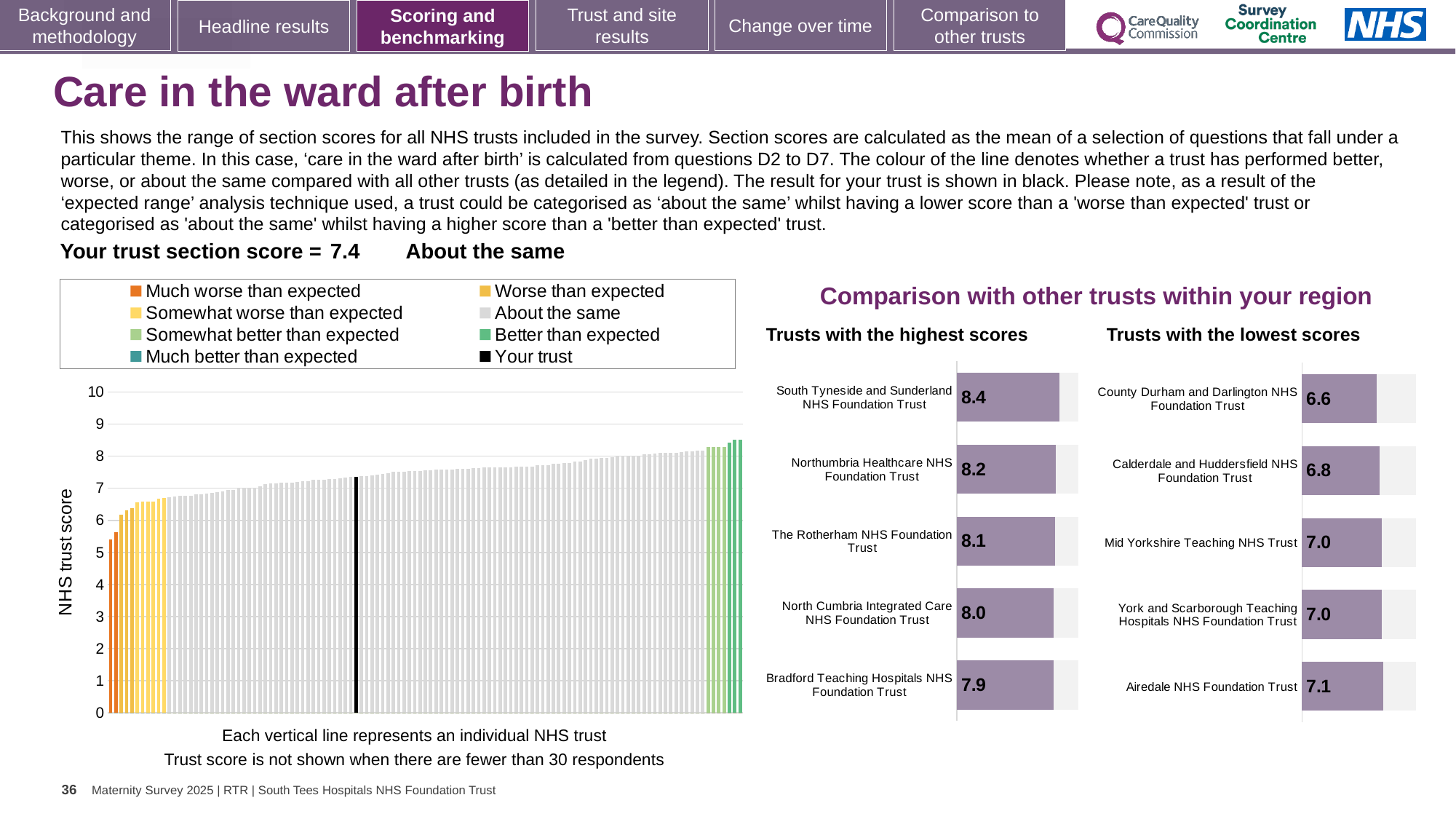
In the 'Trusts with the highest scores' chart, what is the score for South Tyneside and Sunderland NHS Foundation Trust? 8.4 In the main 'NHS trust score' chart, is the value of the lowest (leftmost) bar greater or less than 6? less How many trusts are shown in the 'Trusts with the lowest scores' chart? 5 In the 'Trusts with the highest scores' chart, which trust has the highest score? South Tyneside and Sunderland NHS Foundation Trust In the 'Trusts with the lowest scores' chart, which trust has the lowest score? County Durham and Darlington NHS Foundation Trust How many entries does the legend of the main 'NHS trust score' chart list? 8 In the 'Trusts with the highest scores' chart, what is the difference between the scores of Northumbria Healthcare NHS Foundation Trust and North Cumbria Integrated Care NHS Foundation Trust? 0.2 In the main 'NHS trust score' chart, do the values rise or fall from left to right? rise In the 'Trusts with the highest scores' chart, what is the score for Bradford Teaching Hospitals NHS Foundation Trust? 7.9 In the main 'NHS trust score' chart, what is the score for your trust (the black bar)? 7.4 In the 'Trusts with the lowest scores' chart, what is the score for Airedale NHS Foundation Trust? 7.1 In the 'Trusts with the lowest scores' chart, which has the larger score: Calderdale and Huddersfield NHS Foundation Trust or Mid Yorkshire Teaching NHS Trust? Mid Yorkshire Teaching NHS Trust